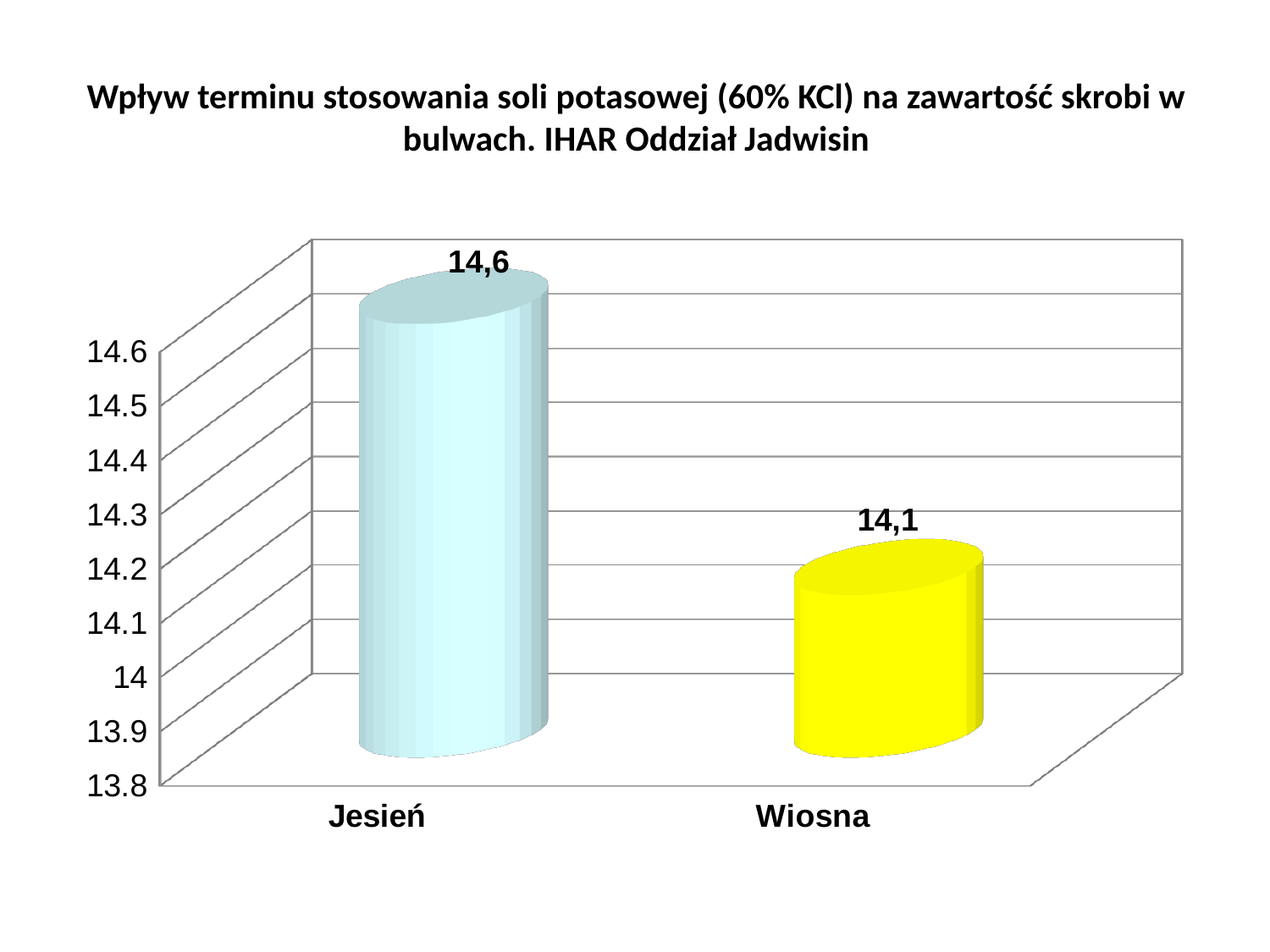
Do the values rise or fall from Jesień to Wiosna? fall Which is larger, the value for Jesień or the value for Wiosna? Jesień What is the value for Wiosna? 14,1 What is the value for Jesień? 14,6 Which category has the highest value? Jesień How many categories are shown on the x axis? 2 What colour is the bar for Wiosna? yellow What is the difference between the values for Jesień and Wiosna? 0,5 Is the value for Jesień greater or less than 14.4? greater Is the value for Wiosna greater or less than 14.3? less What kind of chart is shown on the slide? bar chart Which category has the lowest value? Wiosna